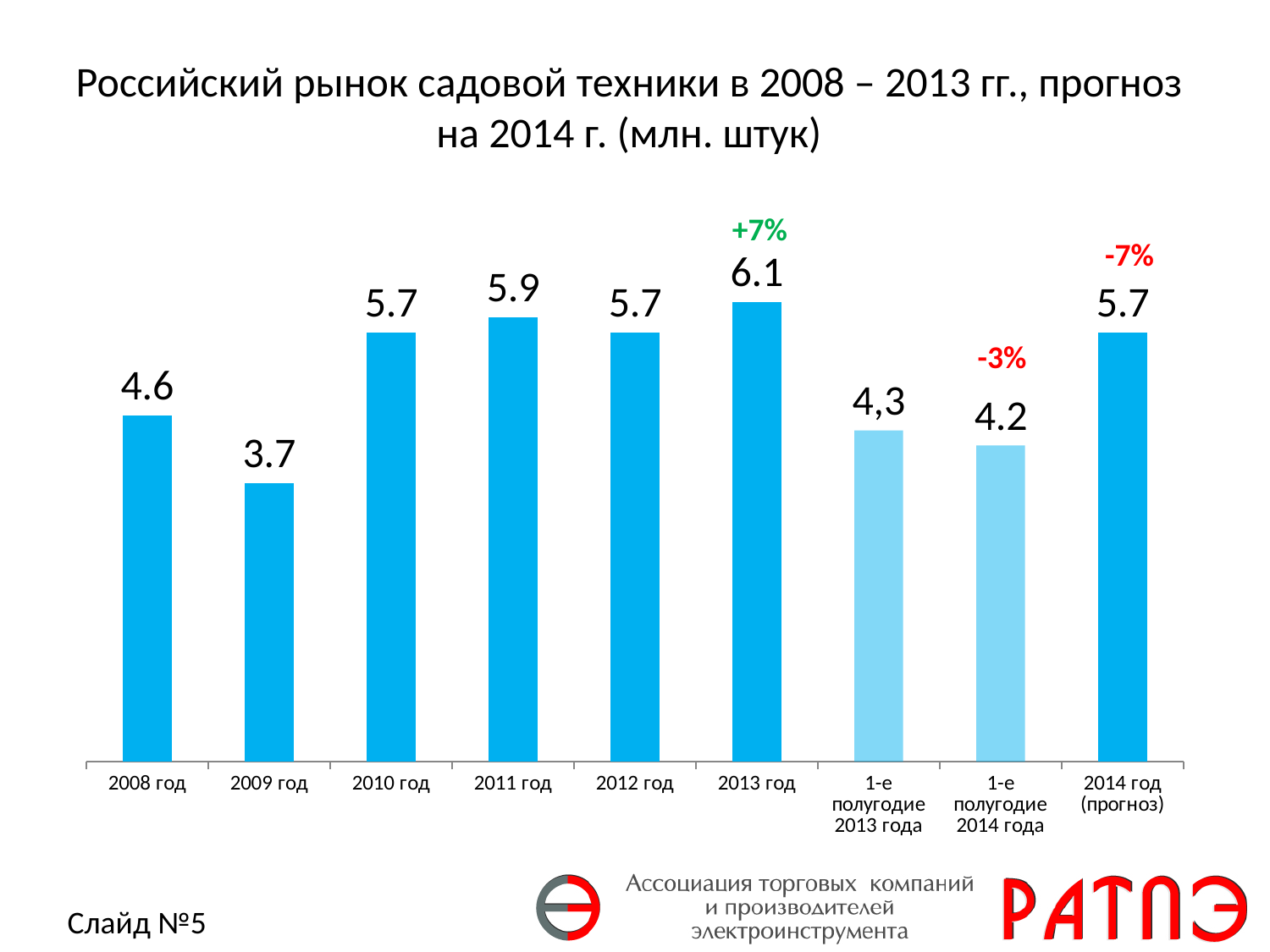
Which is larger, the value for 2011 год or the value for 2010 год? 2011 год Which year has the highest value on the chart? 2013 год What is the value for 2013 год? 6.1 What is the value for 2009 год? 3.7 What is the value for 1-е полугодие 2013 года? 4,3 How many bars are shown on the chart? 9 Which category has the lowest value on the chart? 2009 год What percentage change is shown above the bar for 1-е полугодие 2014 года? -3% What is the forecast value for 2014 год (прогноз)? 5.7 What is the difference between the values for 2013 год and 2012 год? 0.4 What percentage change is shown above the bar for 2014 год (прогноз)? -7% What kind of chart is shown on the slide? bar chart